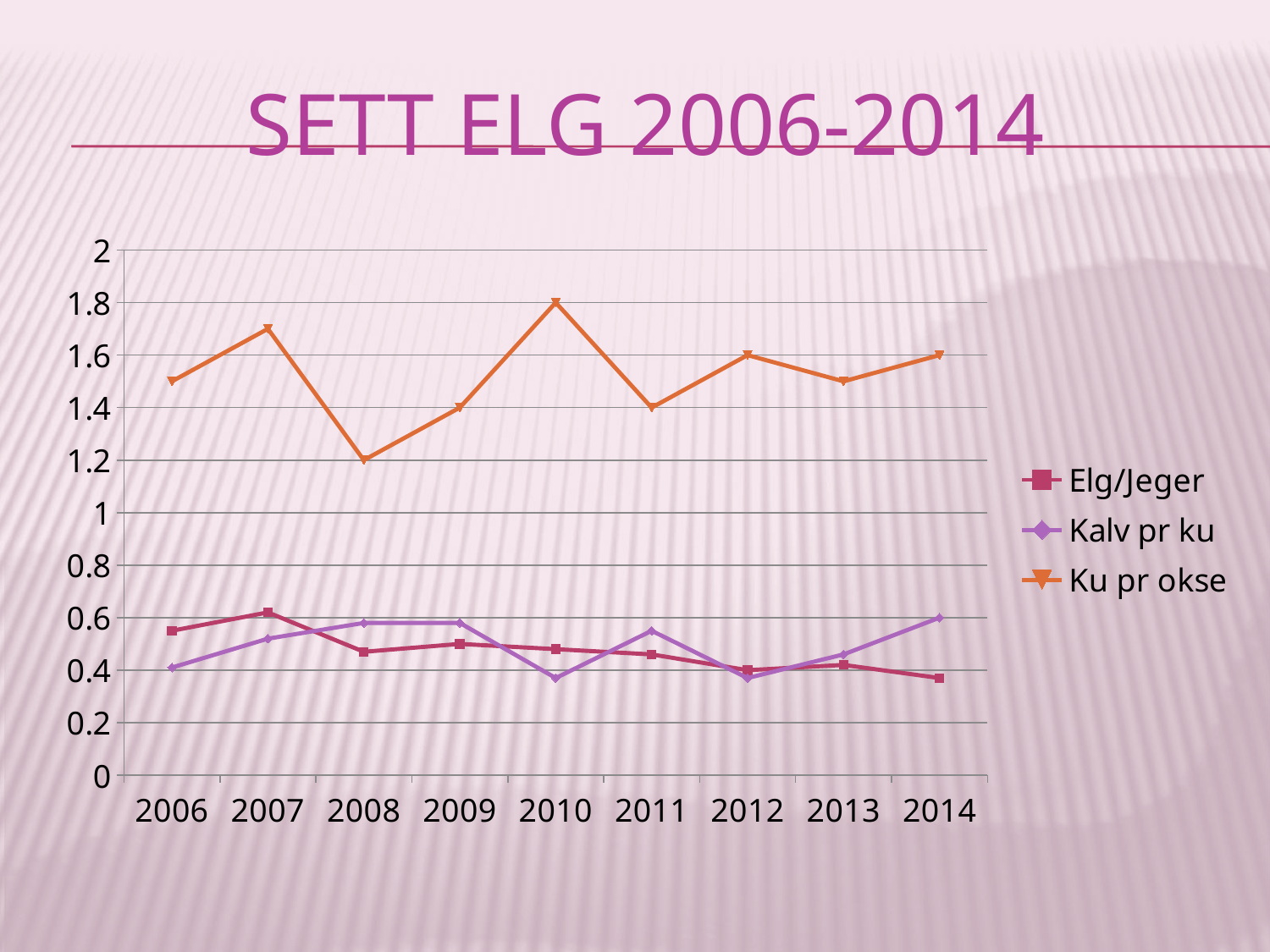
Which is larger in 2014, Elg/Jeger or Kalv pr ku? Kalv pr ku In which year is the Elg/Jeger value highest? 2007 What kind of chart is shown on the slide? line chart What is the difference between the Ku pr okse values in 2010 and 2008? 0.6 In which year is the Ku pr okse value lowest? 2008 What is the Ku pr okse value in 2010? 1.8 How many series does the legend list? 3 Does the Elg/Jeger series rise or fall overall from 2006 to 2014? fall What is the Ku pr okse value in 2008? 1.2 In which year is the Ku pr okse value highest? 2010 Is the Ku pr okse value for 2006 greater or less than 1.4? greater How many years are plotted along the x axis? 9